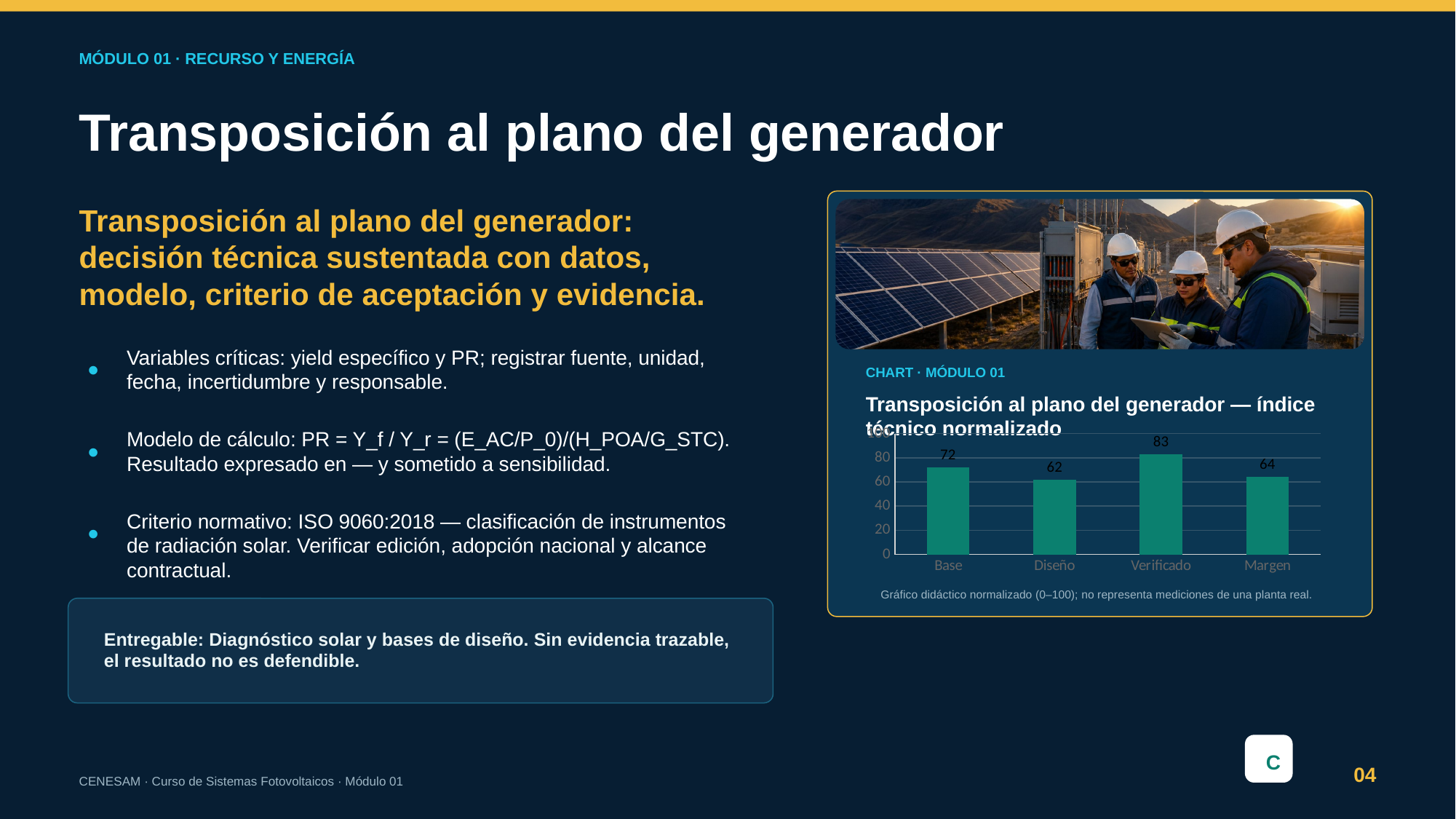
What is the value for Margen? 64 What is the difference between the values for Base and Margen? 8 Which is larger, the value for Base or the value for Margen? Base What is the value for Base? 72 How many categories are shown on the x axis? 4 What is the value for Verificado? 83 What is the title of the chart? Transposición al plano del generador — índice técnico normalizado Which category has the highest value? Verificado What is the value for Diseño? 62 What is the difference between the values for Verificado and Diseño? 21 What kind of chart is shown? Bar chart Which category has the lowest value? Diseño